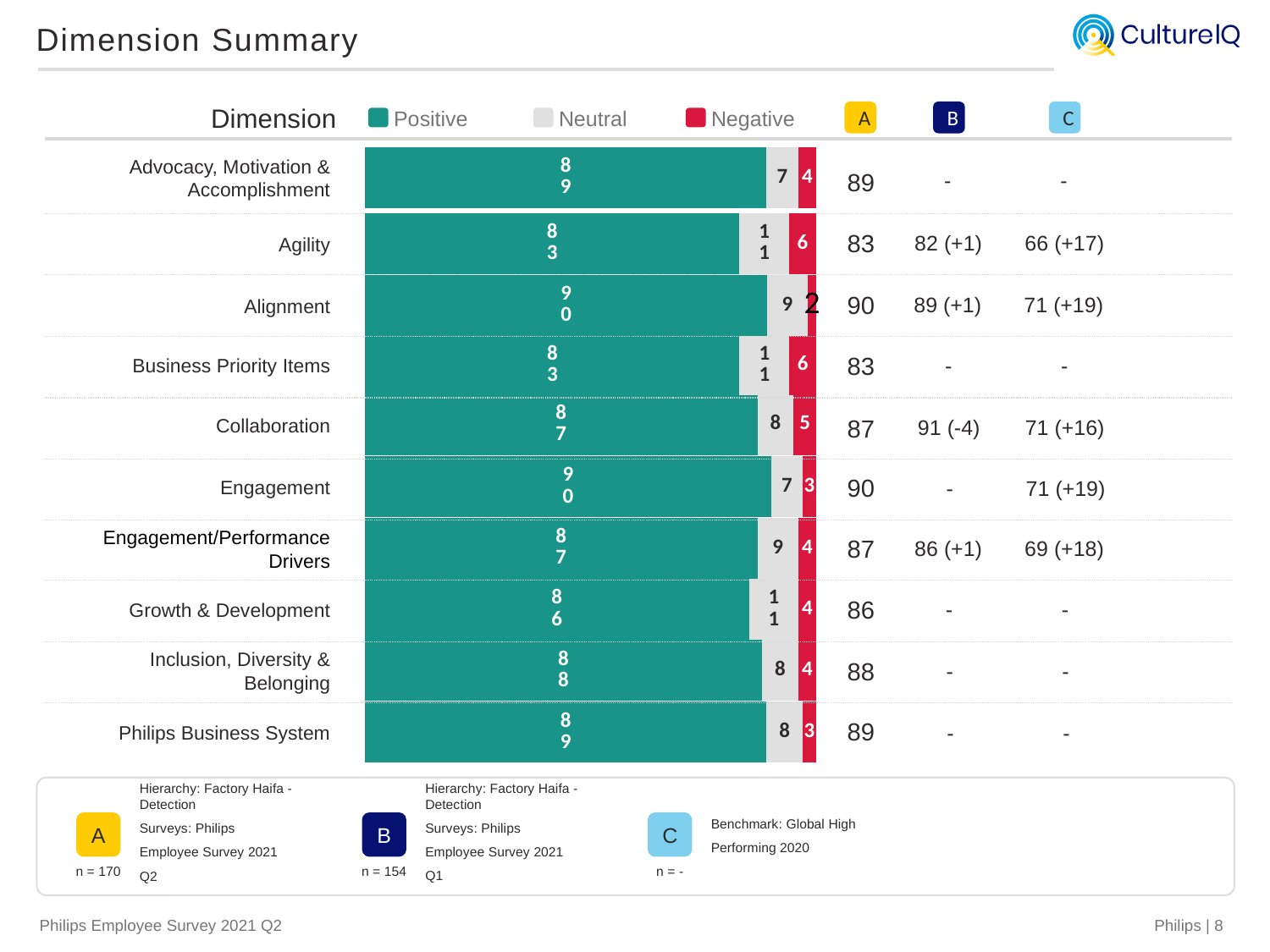
Which has a larger Positive value, Collaboration or Inclusion, Diversity & Belonging? Inclusion, Diversity & Belonging Which colour represents the Negative series in the legend? Red What is the Neutral value for Growth & Development? 11 How many series does the legend list? 3 What kind of chart is shown on the slide? Stacked bar chart What is the Positive value for Agility? 83 What is the total of the Positive, Neutral and Negative values for Engagement? 100 How many dimensions are shown in the chart? 10 What is the Negative value for Alignment? 2 Which dimension has the lowest Negative value? Alignment What is the difference between the Positive values for Alignment and Agility? 7 Which dimension has the highest Negative value? Agility and Business Priority Items (6)